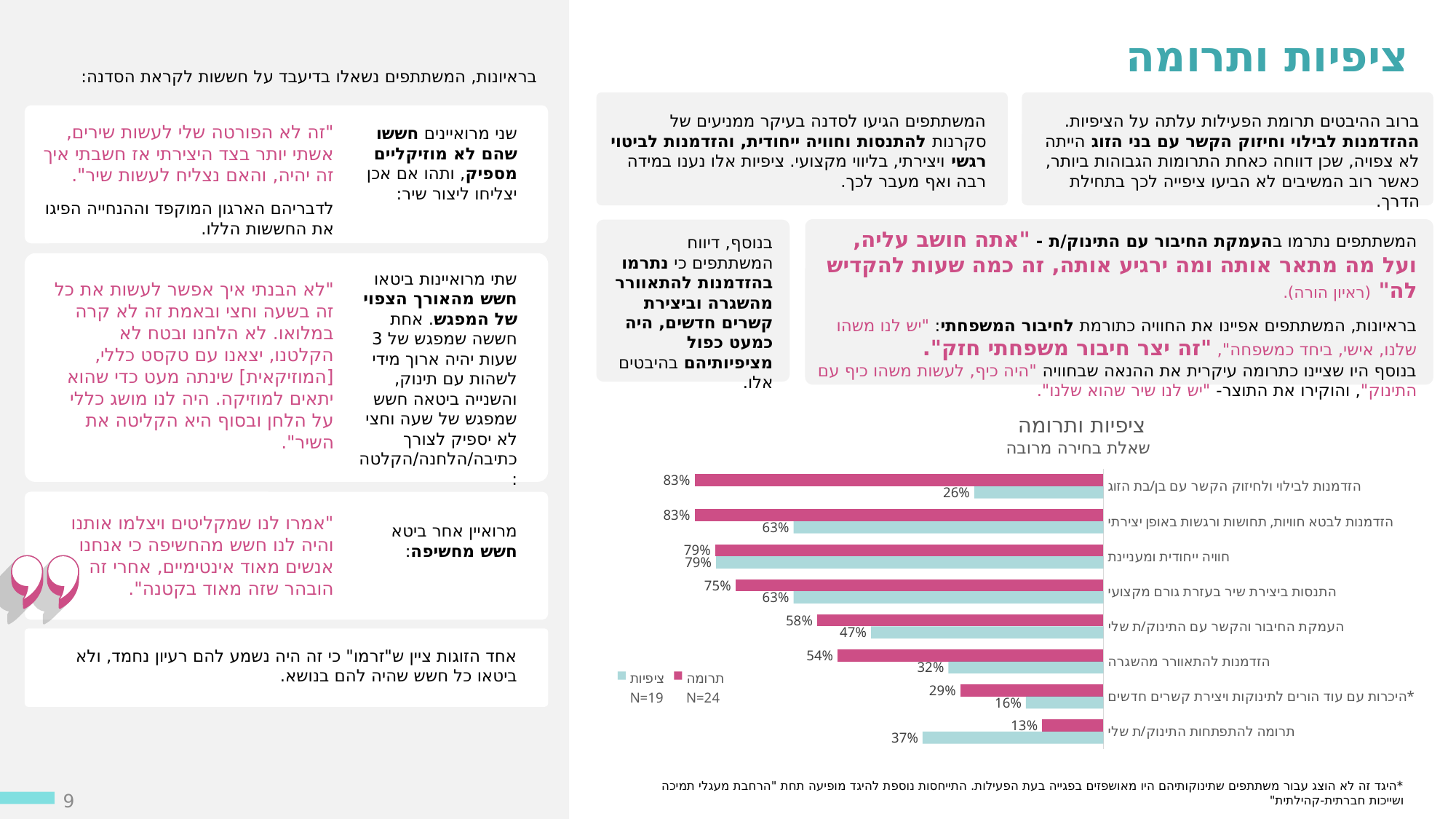
What is the difference between the תרומה and ציפיות values for 'הזדמנות להתאוורר מהשגרה'? 22% What is the sample size (N) shown in the legend for the תרומה series? N=24 How many series does the chart legend list? 2 Which category has the highest ציפיות value? חוויה ייחודית ומעניינת What is the ציפיות value for 'הזדמנות לבילוי ולחיזוק הקשר עם בן/בת הזוג'? 26% What is the תרומה value for 'הזדמנות לבילוי ולחיזוק הקשר עם בן/בת הזוג'? 83% What is the subtitle shown under the chart title 'ציפיות ותרומה'? שאלת בחירה מרובה What is the ציפיות value for 'תרומה להתפתחות התינוק/ת שלי'? 37% How many categories are plotted in the chart? 8 For 'תרומה להתפתחות התינוק/ת שלי', which is larger: the תרומה value or the ציפיות value? ציפיות What type of chart is shown on the slide? bar chart Which category has the lowest תרומה value? תרומה להתפתחות התינוק/ת שלי